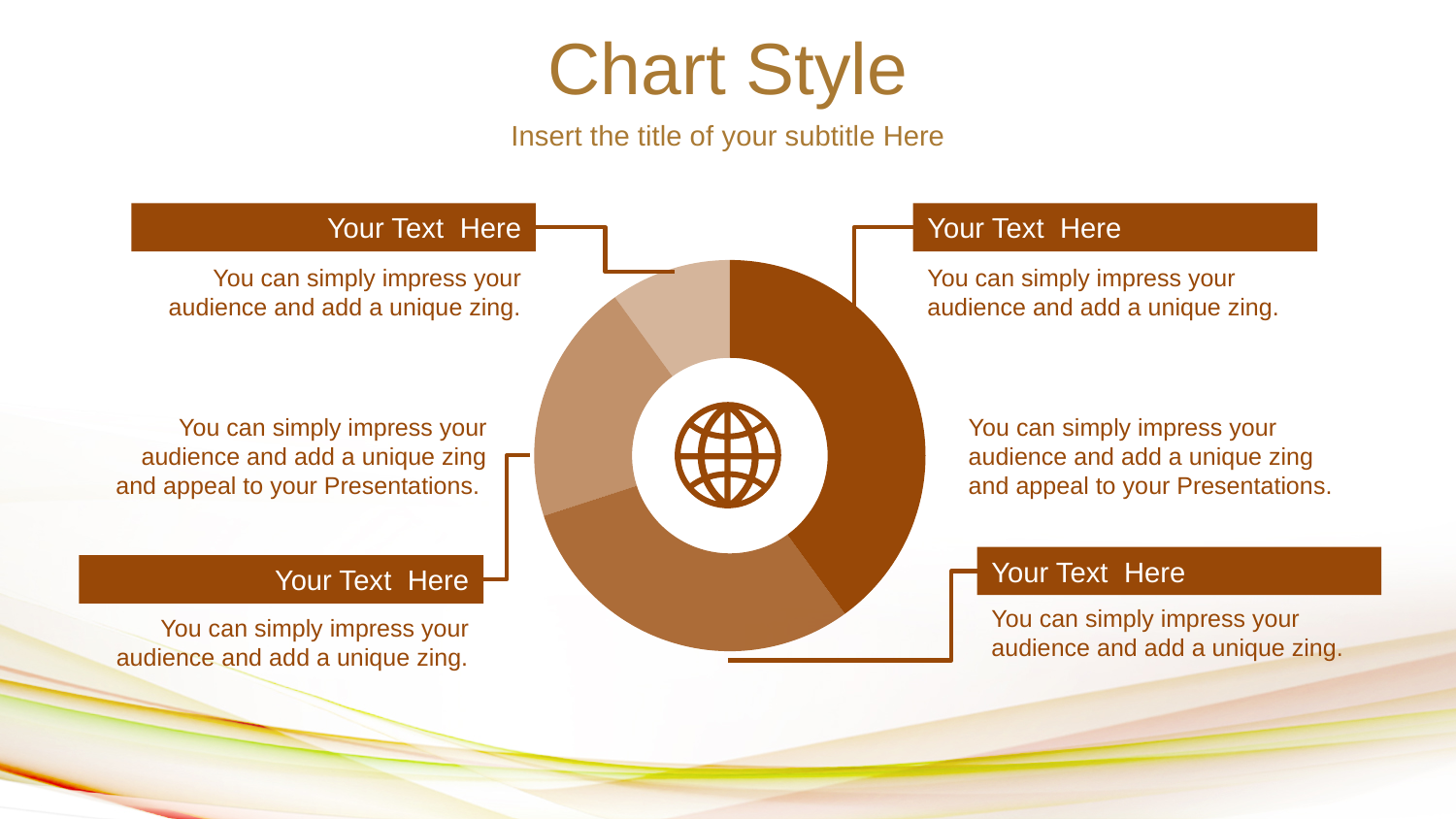
How many segments does the donut chart have? 4 What icon appears in the centre of the donut chart? A globe What is the title of the slide containing the chart? Chart Style Which segment of the donut chart is the largest? The dark brown segment on the right Is the dark brown segment larger than the medium brown segment at the bottom left? Yes What kind of chart is shown on the slide? Donut (pie) chart